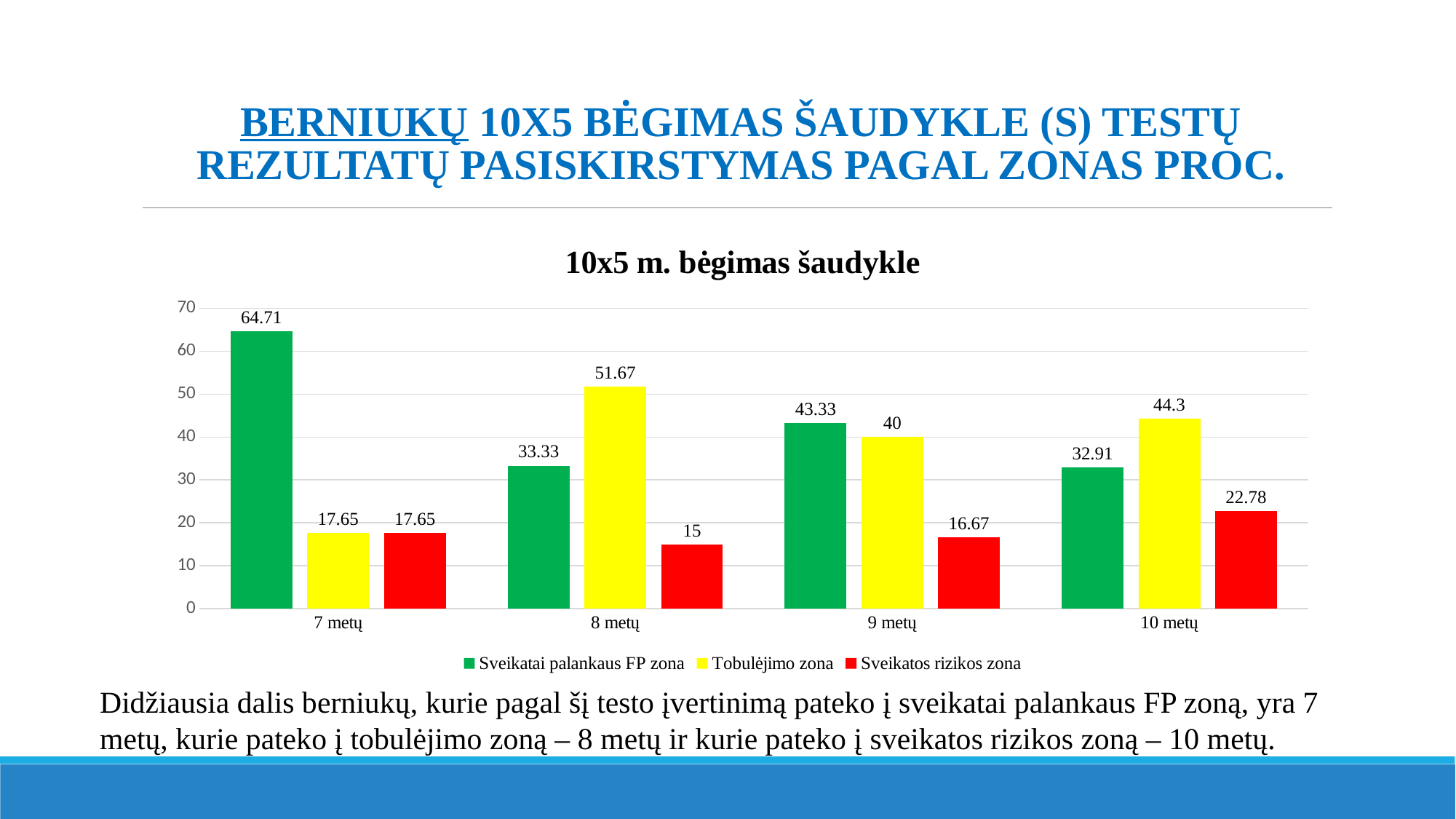
What is the title of the chart? 10x5 m. bėgimas šaudykle How many series does the legend list? 3 What kind of chart is shown on the slide? Bar chart Which age group has the highest value for 'Sveikatai palankaus FP zona'? 7 metų What is the value for 'Sveikatos rizikos zona' at 10 metų? 22.78 What is the value for 'Sveikatos rizikos zona' at 8 metų? 15 What is the difference between the 'Sveikatai palankaus FP zona' value and the 'Tobulėjimo zona' value at 9 metų? 3.33 At 10 metų, which is larger: 'Sveikatai palankaus FP zona' or 'Tobulėjimo zona'? Tobulėjimo zona What is the value for 'Tobulėjimo zona' at 8 metų? 51.67 How many age groups are shown on the x axis? 4 Which age group has the lowest value for 'Sveikatos rizikos zona'? 8 metų What is the value for 'Sveikatai palankaus FP zona' at 7 metų? 64.71